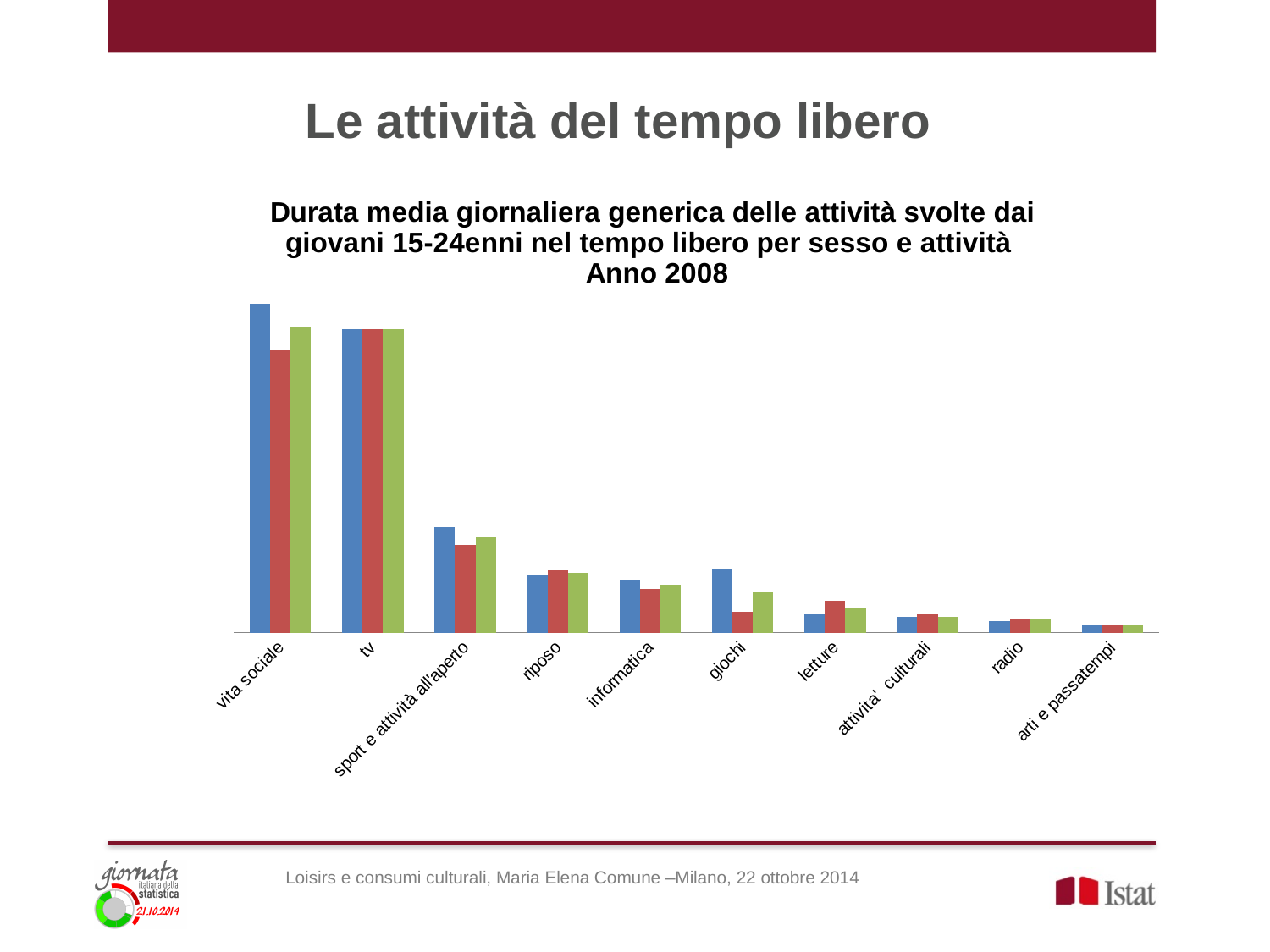
Which activity category has the shortest bars in the chart? arti e passatempi For giochi, which bar is taller, the blue one or the red one? the blue one Which activity category has the tallest bar in the chart? vita sociale Which category has the taller blue bar, vita sociale or tv? vita sociale How many bars are plotted for each activity category? 3 How many activity categories are shown on the x axis of the chart? 10 Which category has taller bars, sport e attività all'aperto or riposo? sport e attività all'aperto Do the bar heights generally rise or fall moving from left to right along the x axis? fall What age group of young people does the chart title say the data covers? 15-24enni What kind of chart is shown on the slide? bar chart Which year does the chart's data refer to, according to its title? 2008